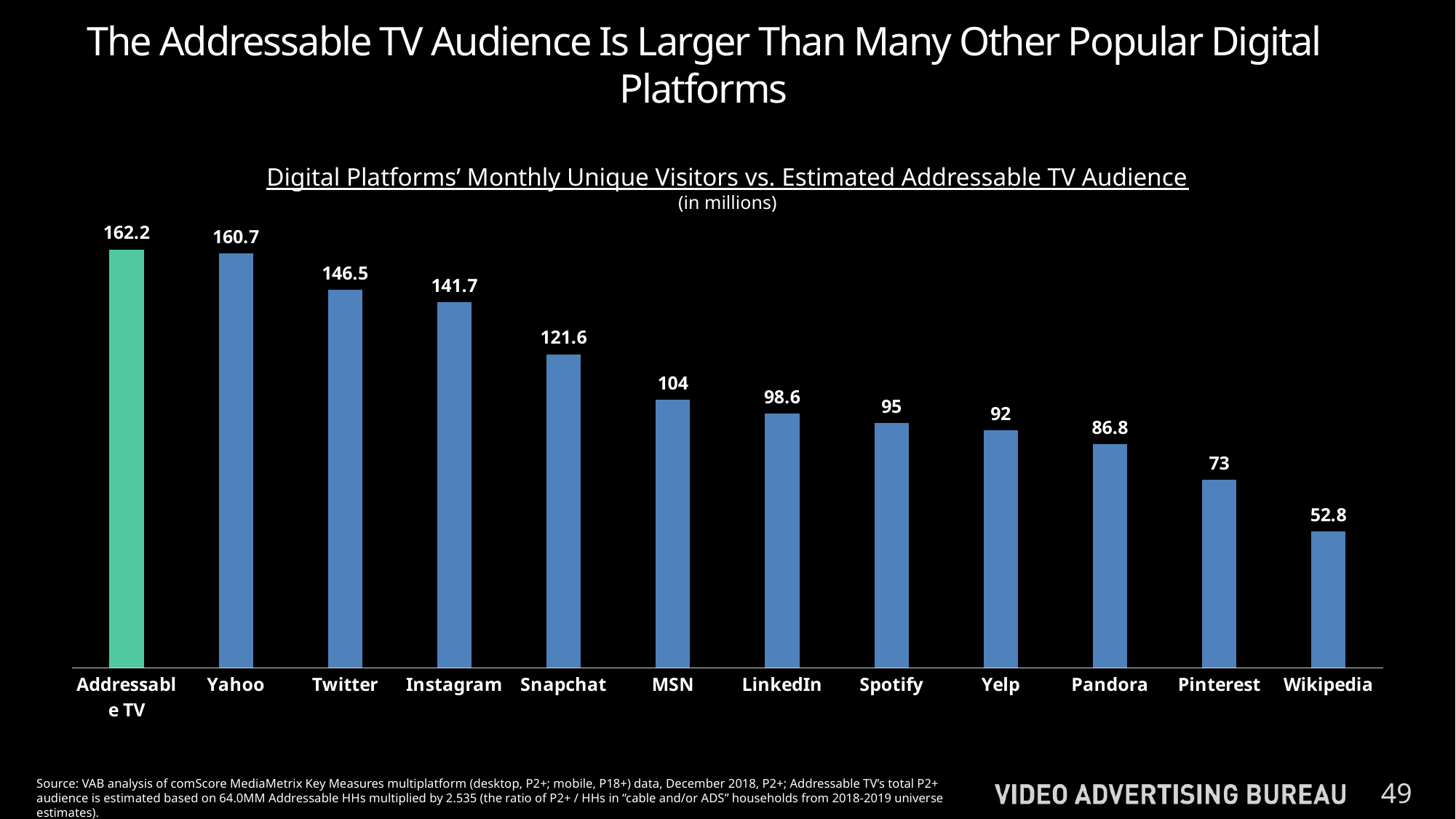
Which is larger, the value for MSN or the value for LinkedIn? MSN Which category has the lowest value? Wikipedia What is the value for Addressable TV? 162.2 What is the difference between the values for Addressable TV and Wikipedia? 109.4 How many categories are shown in the chart? 12 What is the difference between the values for Twitter and Instagram? 4.8 What unit is stated under the chart title? in millions What kind of chart is shown on the slide? Bar chart What is the value for Snapchat? 121.6 Which is larger, the value for Pinterest or the value for Yelp? Yelp Which category has the highest value? Addressable TV What is the value for Pandora? 86.8